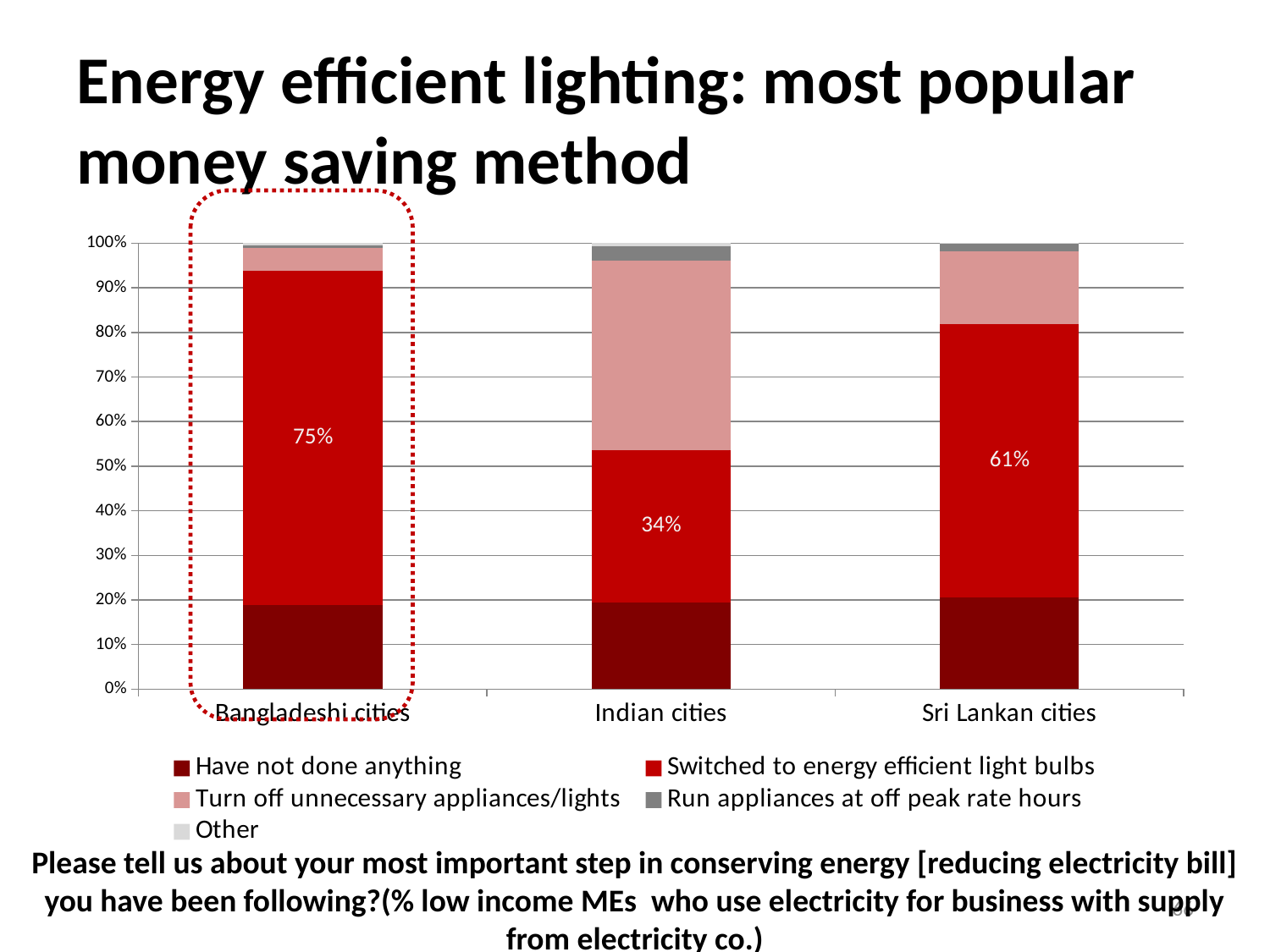
Which city group has the lowest share for 'Switched to energy efficient light bulbs'? Indian cities Is the 'Have not done anything' segment for Bangladeshi cities greater or less than 30%? less Is the 'Turn off unnecessary appliances/lights' segment for Indian cities greater or less than 30%? greater How many series does the chart legend list? 5 How many city groups are shown on the x axis of the chart? 3 What percentage of low income MEs in Bangladeshi cities switched to energy efficient light bulbs? 75% How many percentage points higher is the 'Switched to energy efficient light bulbs' share in Bangladeshi cities than in Indian cities? 41 percentage points Which city group has the highest share for 'Switched to energy efficient light bulbs'? Bangladeshi cities What type of chart is shown on the slide? Stacked bar chart What is the value for 'Switched to energy efficient light bulbs' in Indian cities? 34% What is the value for 'Switched to energy efficient light bulbs' in Sri Lankan cities? 61% Which has a larger share for 'Switched to energy efficient light bulbs': Sri Lankan cities or Indian cities? Sri Lankan cities